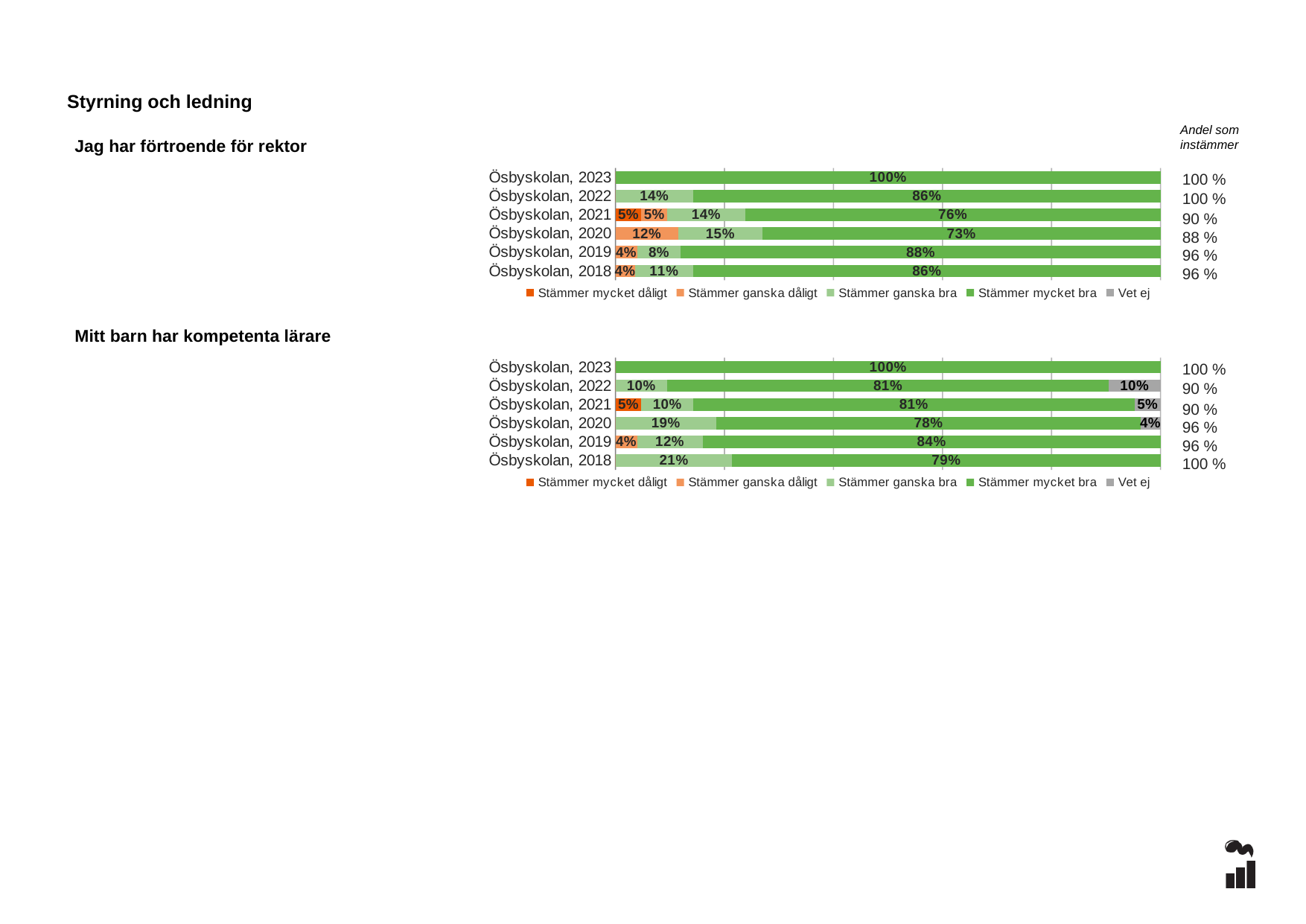
How many series does the legend of the chart 'Mitt barn har kompetenta lärare' list? 5 What kind of chart is 'Jag har förtroende för rektor'? Stacked bar chart In the chart 'Mitt barn har kompetenta lärare', what is the 'Andel som instämmer' value shown for Ösbyskolan, 2020? 96 % In the chart 'Jag har förtroende för rektor', what is the value for 'Stämmer ganska bra' for Ösbyskolan, 2022? 14% In the chart 'Jag har förtroende för rektor', how many categories (bars) are shown? 6 In the chart 'Jag har förtroende för rektor', what is the difference between the 'Stämmer mycket bra' values for Ösbyskolan, 2019 and Ösbyskolan, 2020? 15% In the chart 'Jag har förtroende för rektor', which year has the lowest value for 'Stämmer mycket bra'? Ösbyskolan, 2020 In the chart 'Mitt barn har kompetenta lärare', what is the value for 'Stämmer ganska bra' for Ösbyskolan, 2018? 21% In the chart 'Mitt barn har kompetenta lärare', what is the value for 'Vet ej' for Ösbyskolan, 2022? 10% In the chart 'Mitt barn har kompetenta lärare', is the 'Stämmer mycket bra' value larger for Ösbyskolan, 2019 or Ösbyskolan, 2020? Ösbyskolan, 2019 In the chart 'Jag har förtroende för rektor', what is the value for 'Stämmer mycket bra' for Ösbyskolan, 2021? 76% In the chart 'Mitt barn har kompetenta lärare', which year has the highest value for 'Stämmer mycket bra'? Ösbyskolan, 2023